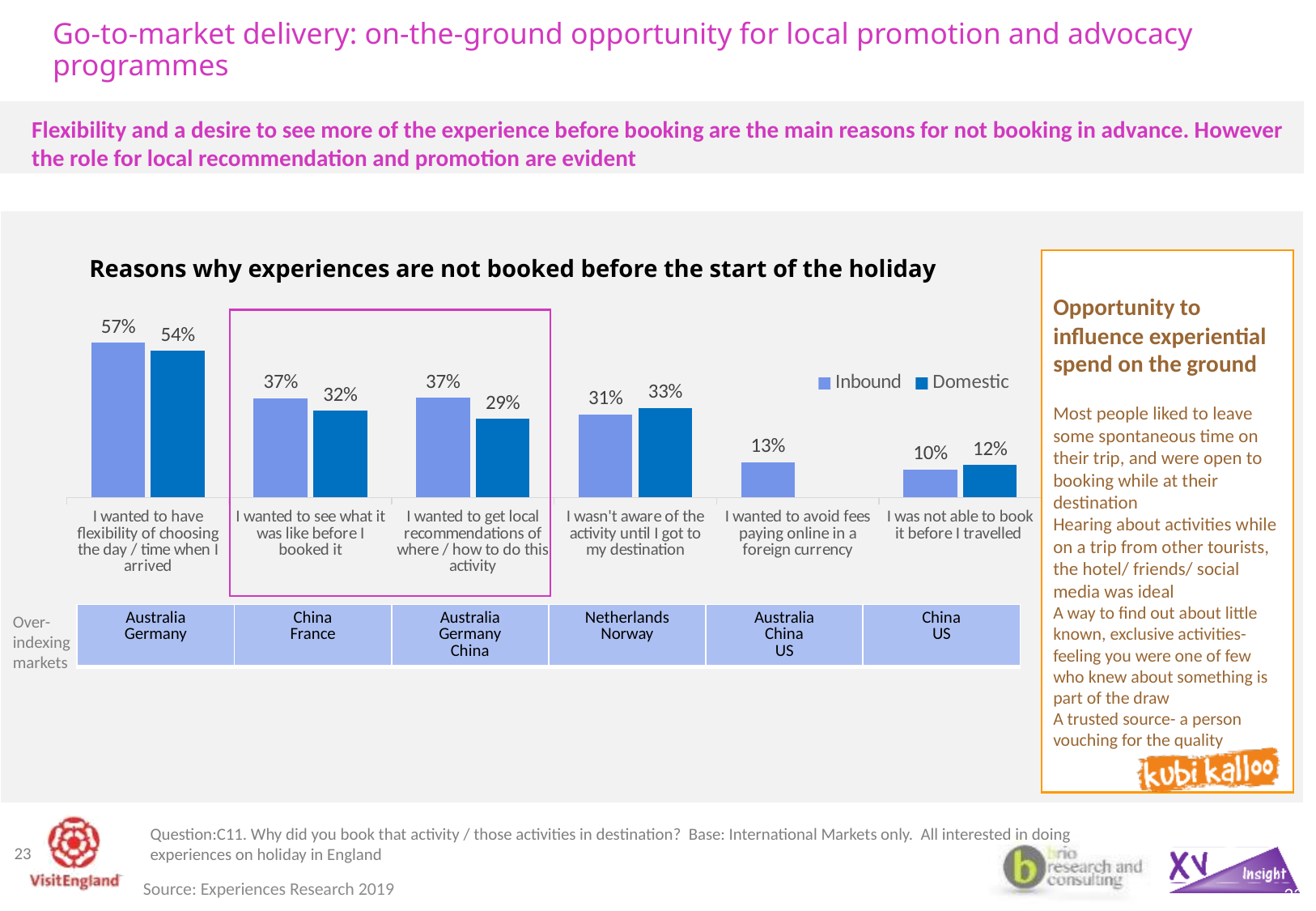
What are the two series named in the chart legend? Inbound and Domestic What is the difference between the Inbound and Domestic values for 'I wanted to get local recommendations of where / how to do this activity'? 8% What is the Inbound value for 'I wanted to have flexibility of choosing the day / time when I arrived'? 57% Which reason has the highest Inbound value? I wanted to have flexibility of choosing the day / time when I arrived What is the Domestic value for 'I wanted to see what it was like before I booked it'? 32% What is the Inbound value for 'I was not able to book it before I travelled'? 10% How many reasons (categories) are shown on the x axis of the chart? 6 What is the Domestic value for 'I wanted to get local recommendations of where / how to do this activity'? 29% For 'I wasn't aware of the activity until I got to my destination', which is larger, the Inbound or the Domestic value? Domestic How many series does the chart legend list? 2 Which reason has the lowest Domestic value? I was not able to book it before I travelled What type of chart is used to show the reasons why experiences are not booked before the start of the holiday? Bar chart